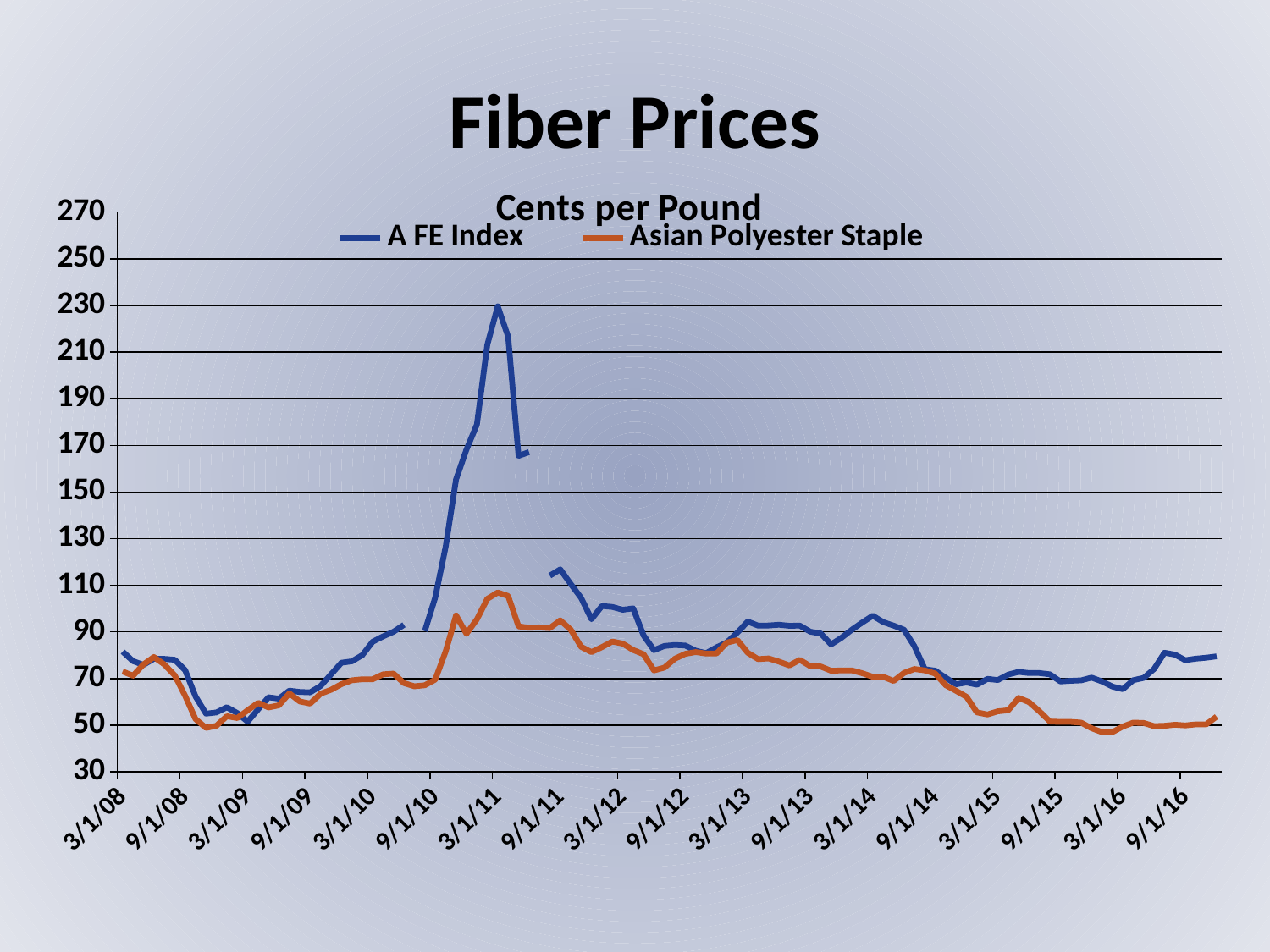
What unit is given in the chart subtitle? Cents per Pound How many series does the legend list? 2 Does the Asian Polyester Staple series generally rise or fall between 3/1/13 and 3/1/16? fall Is the value of Asian Polyester Staple at 3/1/11 greater or less than 90? greater Is the value of Asian Polyester Staple at 3/1/15 greater or less than 70? less What is the title of the chart? Cents per Pound Is the value of the A FE Index at 3/1/11 greater or less than 190? greater Which series reaches the highest value on the chart? A FE Index Which series has the larger value at 3/1/15, A FE Index or Asian Polyester Staple? A FE Index Around which x-axis date does the A FE Index reach its peak? 3/1/11 How many date labels are shown on the x axis? 18 What kind of chart is shown on the slide? line chart